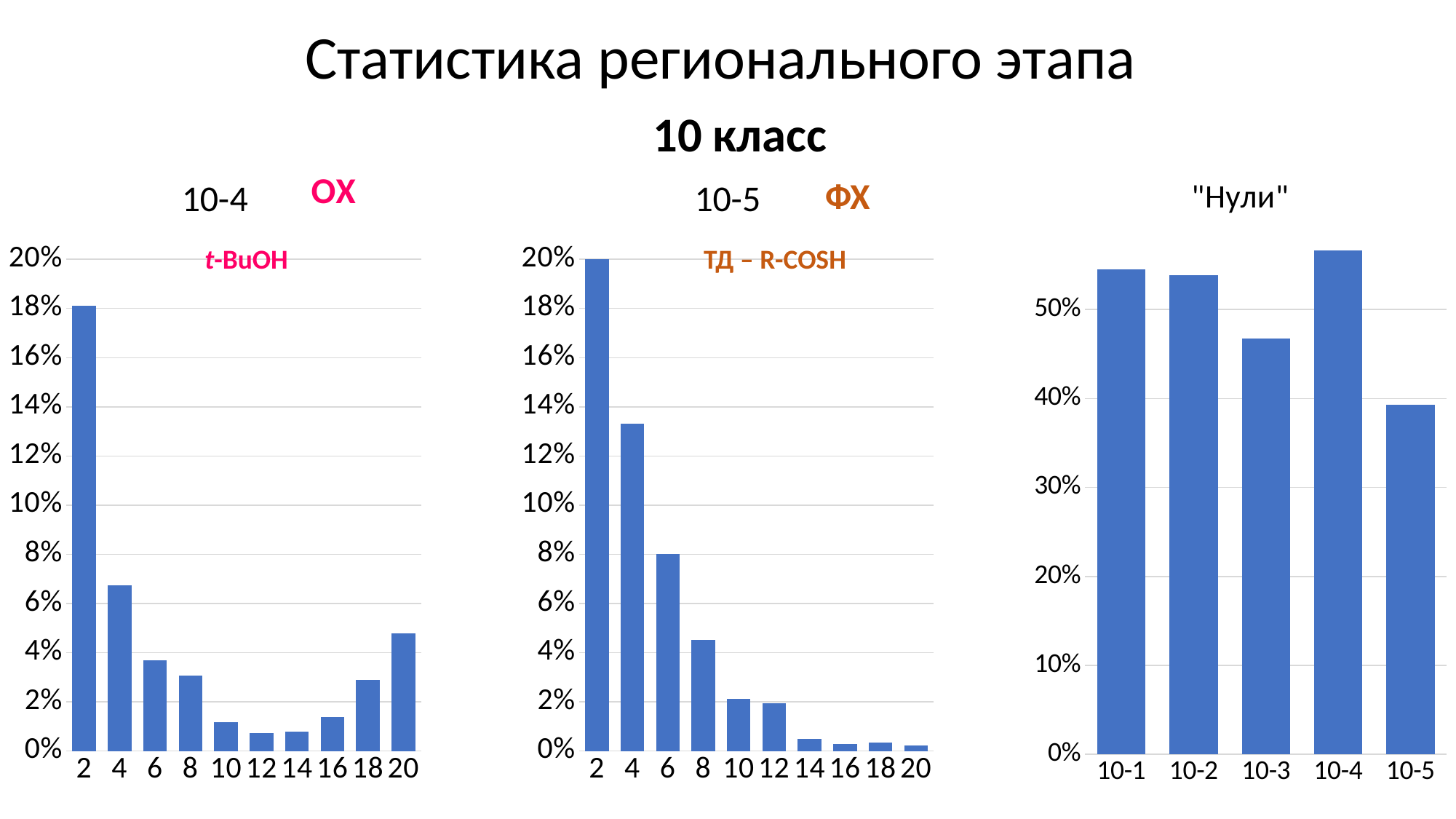
How many bars does the "Нули" chart on the right of the slide have? 5 In the "Нули" chart on the right, is the value for 10-5 greater or less than 40%? less In the "Нули" chart on the right, which category has the lowest value? 10-5 How many categories are shown on the x axis of the "10-5" chart in the middle of the slide? 10 In the "10-4" chart on the left, is the value for category 2 greater or less than 16%? greater In the "10-4" chart on the left, which category has the highest value? 2 In the "Нули" chart on the right, which is larger: the value for 10-3 or the value for 10-5? 10-3 What kind of chart is the "10-4" chart on the left of the slide? bar chart In the "10-4" chart on the left, which is larger: the value for category 4 or the value for category 20? 4 In the "10-5" chart in the middle, which category has the highest value? 2 In the "Нули" chart on the right, which category has the highest value? 10-4 In the "10-5" chart in the middle, is the value for category 4 greater or less than 12%? greater